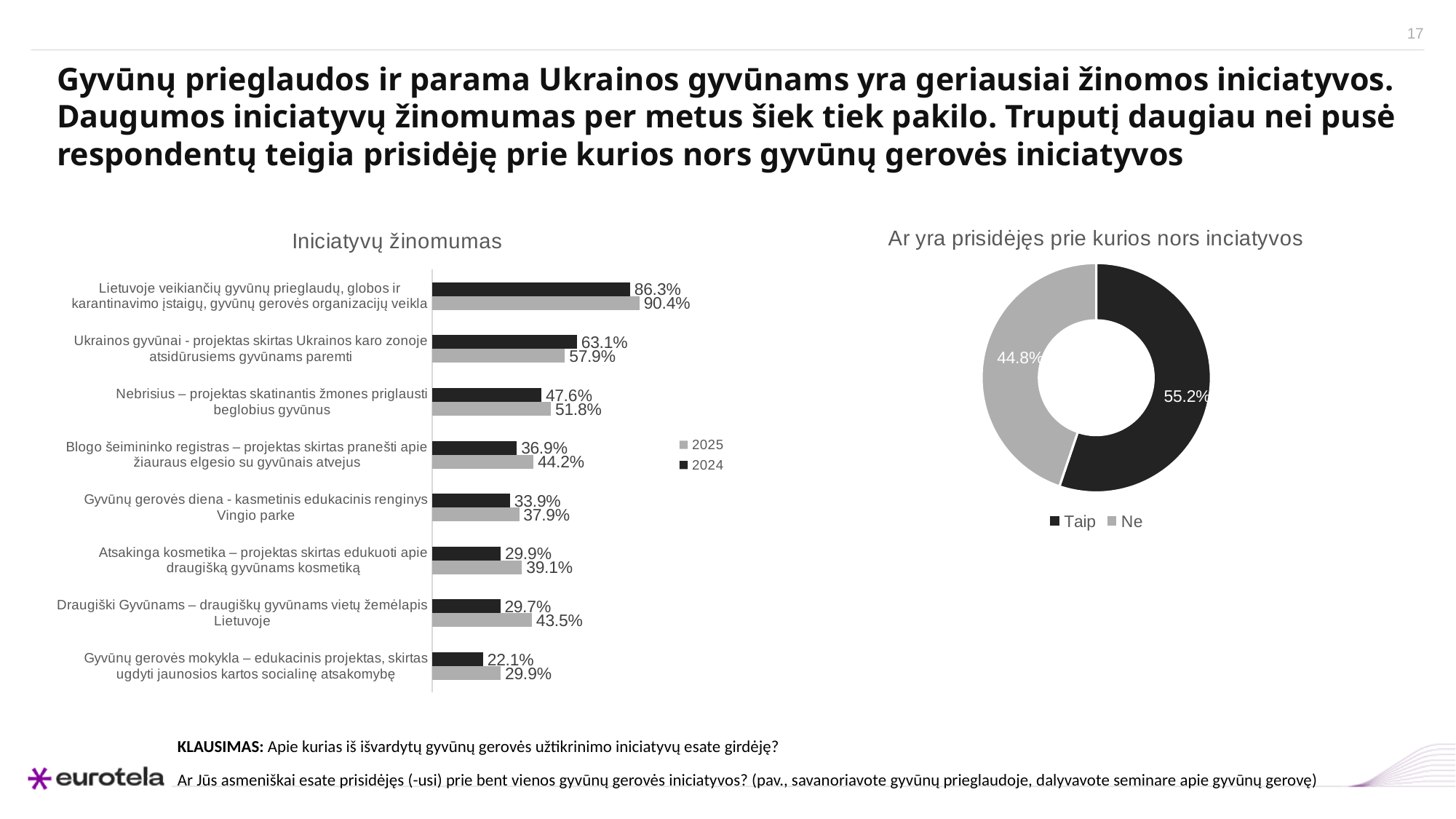
How many series does the legend of the 'Iniciatyvų žinomumas' chart list? 2 In the 'Iniciatyvų žinomumas' chart, which category has the highest 2025 value? Lietuvoje veikiančių gyvūnų prieglaudų, globos ir karantinavimo įstaigų, gyvūnų gerovės organizacijų veikla In the 'Iniciatyvų žinomumas' chart, what is the 2025 value for 'Ukrainos gyvūnai - projektas skirtas Ukrainos karo zonoje atsidūrusiems gyvūnams paremti'? 57.9% In the 'Iniciatyvų žinomumas' chart, for 'Blogo šeimininko registras', is the 2024 value or the 2025 value larger? 2025 In the 'Iniciatyvų žinomumas' chart, which category has the lowest 2024 value? Gyvūnų gerovės mokykla – edukacinis projektas, skirtas ugdyti jaunosios kartos socialinę atsakomybę In the 'Iniciatyvų žinomumas' chart, what is the 2024 value for 'Nebrisius – projektas skatinantis žmones priglausti beglobius gyvūnus'? 47.6% In the 'Iniciatyvų žinomumas' chart, what is the difference between the 2025 and 2024 values for 'Draugiški Gyvūnams – draugiškų gyvūnams vietų žemėlapis Lietuvoje'? 13.8% What kind of chart is 'Iniciatyvų žinomumas'? Bar chart How many categories are shown in the 'Iniciatyvų žinomumas' chart? 8 In the 'Iniciatyvų žinomumas' chart, which colour represents the 2024 series? Black In the 'Ar yra prisidėjęs prie kurios nors inciatyvos' chart, which slice is larger, 'Taip' or 'Ne'? Taip In the 'Ar yra prisidėjęs prie kurios nors inciatyvos' chart, what share of respondents answered 'Taip'? 55.2%